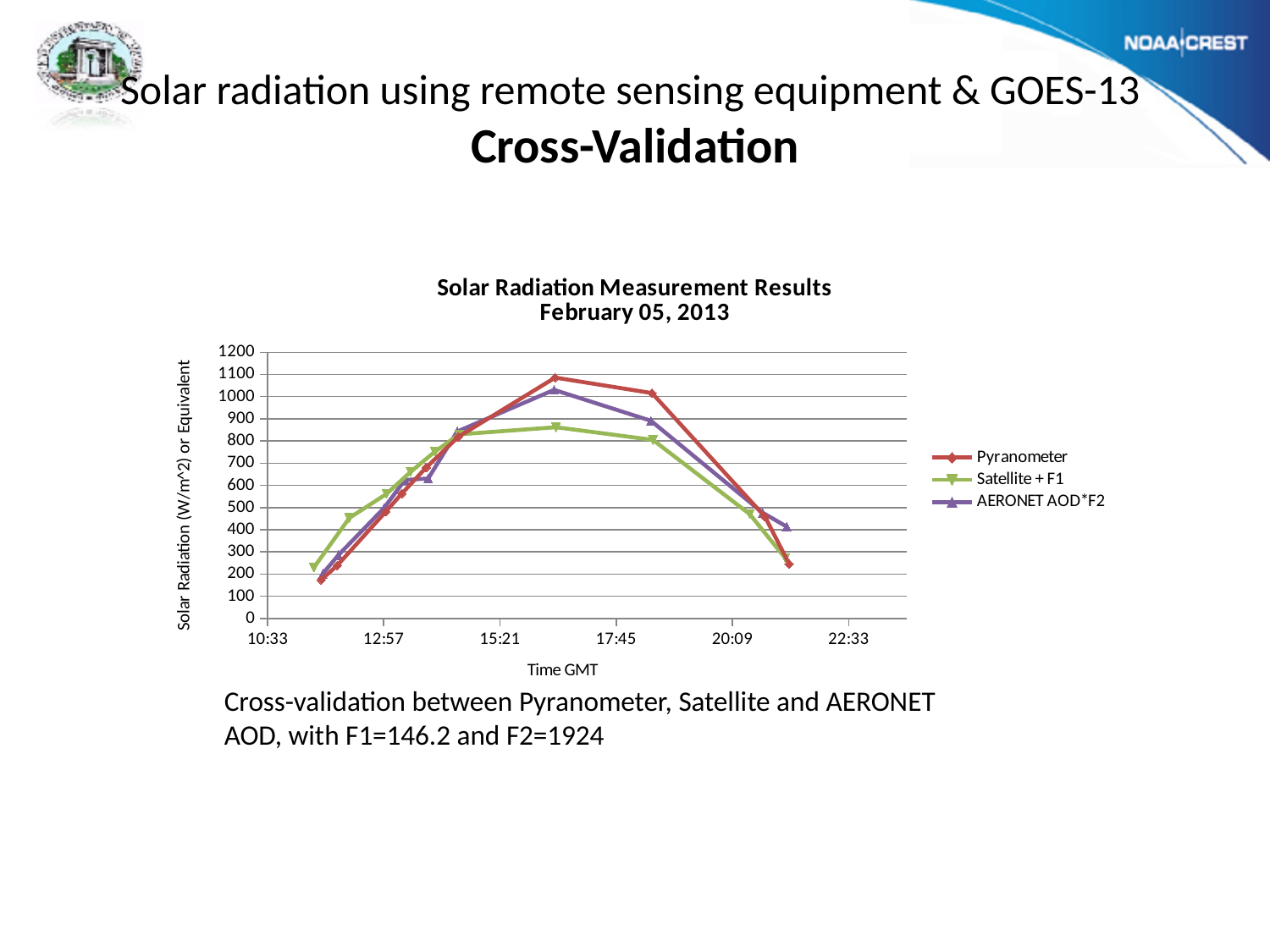
What kind of chart is shown on the slide? line chart Is the last Pyranometer value (around 21:00) greater or less than 300? less Which series reaches the highest peak value? Pyranometer How many time tick labels are shown on the x axis? 6 What is the label of the x axis? Time GMT How do the values change along the x axis over the day? They rise to a peak in the afternoon and then fall What are the three series named in the legend? Pyranometer, Satellite + F1, AERONET AOD*F2 Is the peak value of the Satellite + F1 series greater or less than 900? less Is the peak value of the Pyranometer series greater or less than 1000? greater Which series has the lowest peak value? Satellite + F1 What is the title of the chart? Solar Radiation Measurement Results February 05, 2013 How many series does the legend list? 3